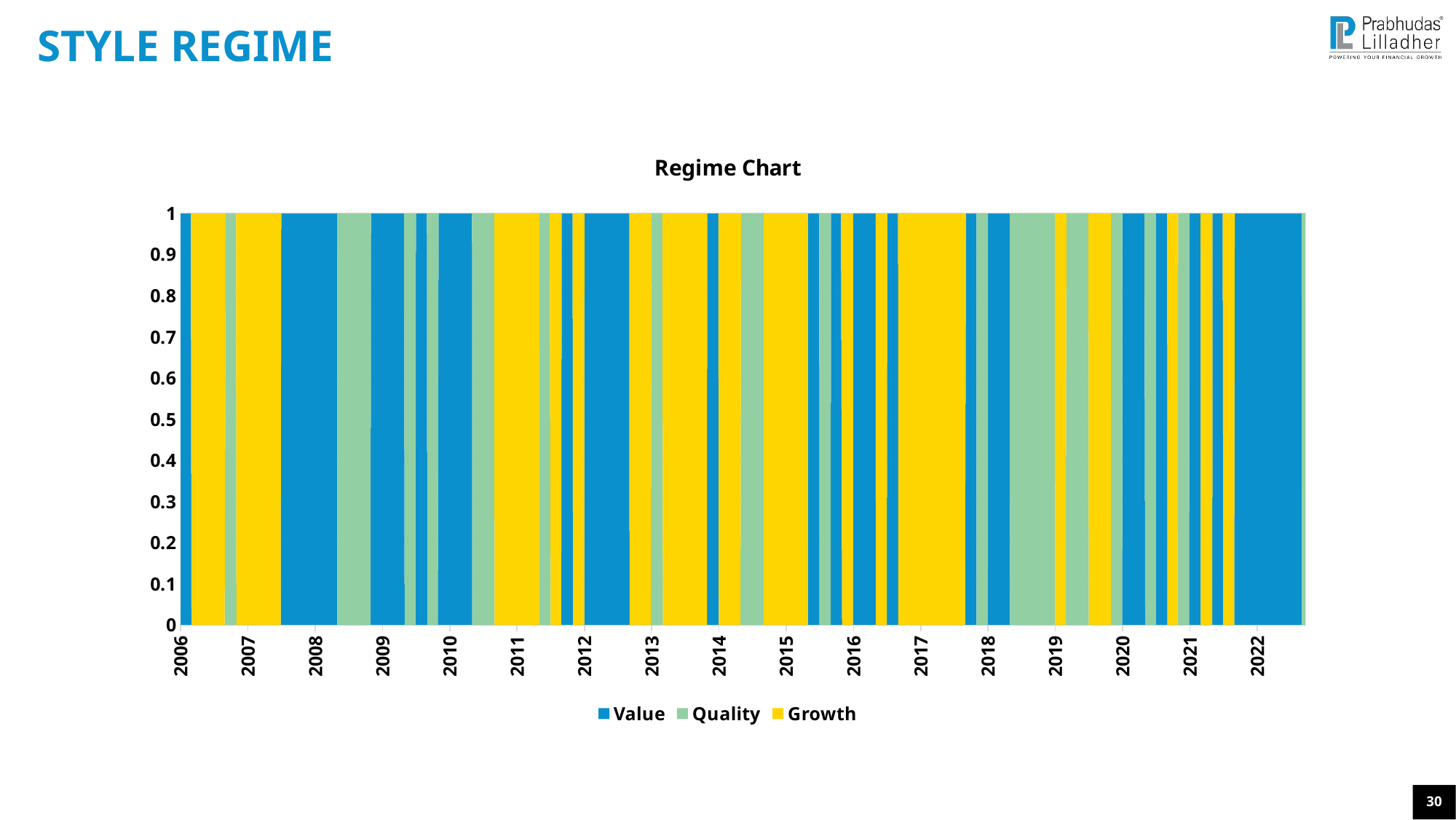
How many year labels are shown on the x axis of the Regime Chart? 17 What is the title of the chart on the slide? Regime Chart Which series is in regime at the 2017 label in the Regime Chart? Growth Which series is in regime at the 2016 label in the Regime Chart? Value Which series is in regime at the 2008 label in the Regime Chart? Value What kind of chart is the Regime Chart? Bar chart Which series is in regime at the 2022 label in the Regime Chart? Value What is the total height of each stacked bar in the Regime Chart? 1 What is the highest value shown on the y axis of the Regime Chart? 1 How many series does the legend of the Regime Chart list? 3 Which colour represents the Growth series in the Regime Chart? Yellow Which series is in regime at the 2011 label in the Regime Chart? Growth